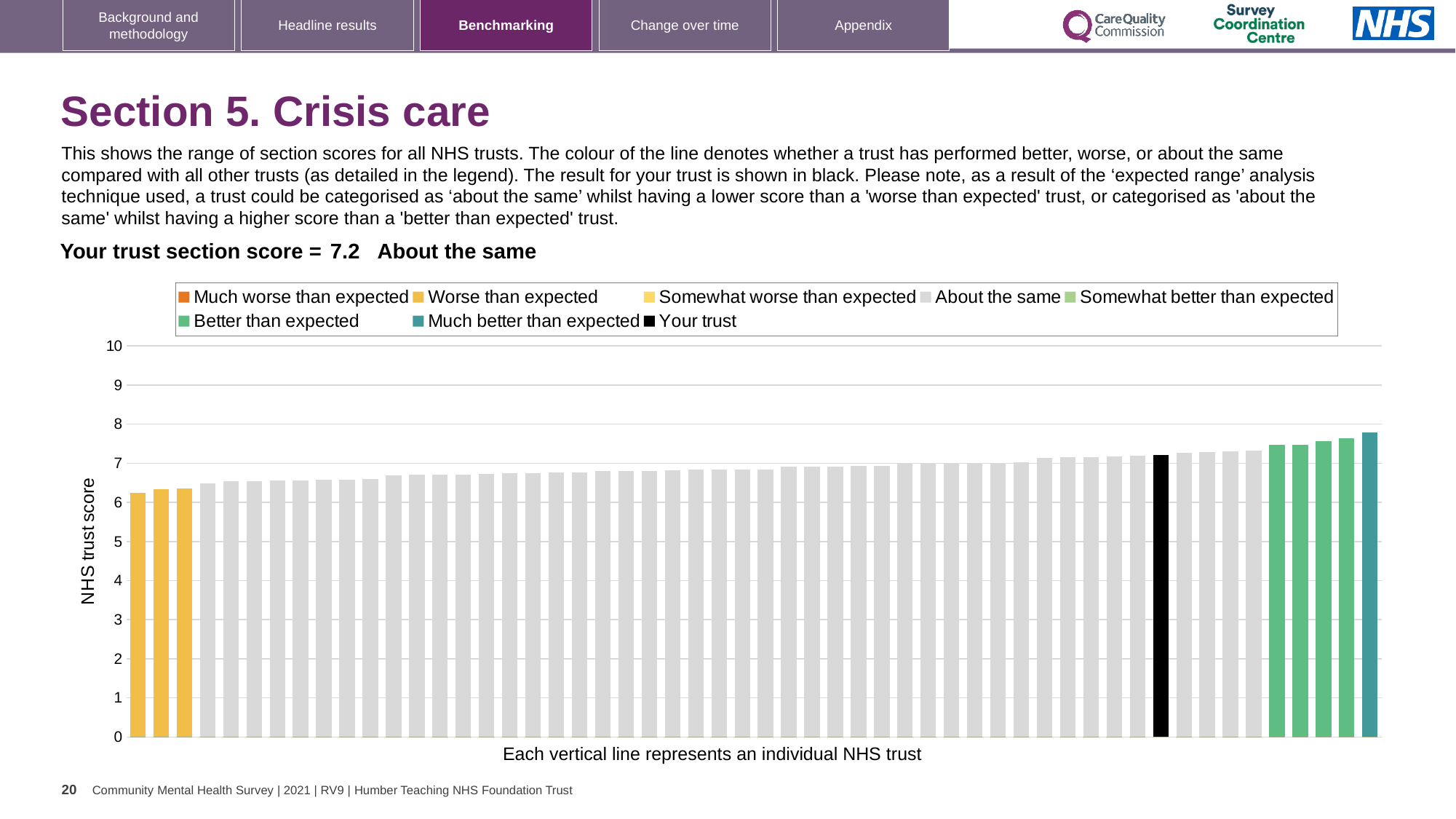
What colour is the bar representing your trust? black Do the bar values rise or fall from left to right along the x axis? rise Is the value of the black 'Your trust' bar greater or less than 7? greater How many bars are coloured yellow ('Worse than expected')? 3 Is the value of the rightmost bar greater or less than 8? less Is the value of the leftmost bar greater or less than 7? less What is the trust section score shown on the slide? 7.2 Which is taller, the black 'Your trust' bar or the rightmost bar? the rightmost bar How many entries does the chart legend list? 8 What is the label on the vertical axis of the chart? NHS trust score What kind of chart is shown on the slide? bar chart How many bars are coloured teal ('Much better than expected')? 1